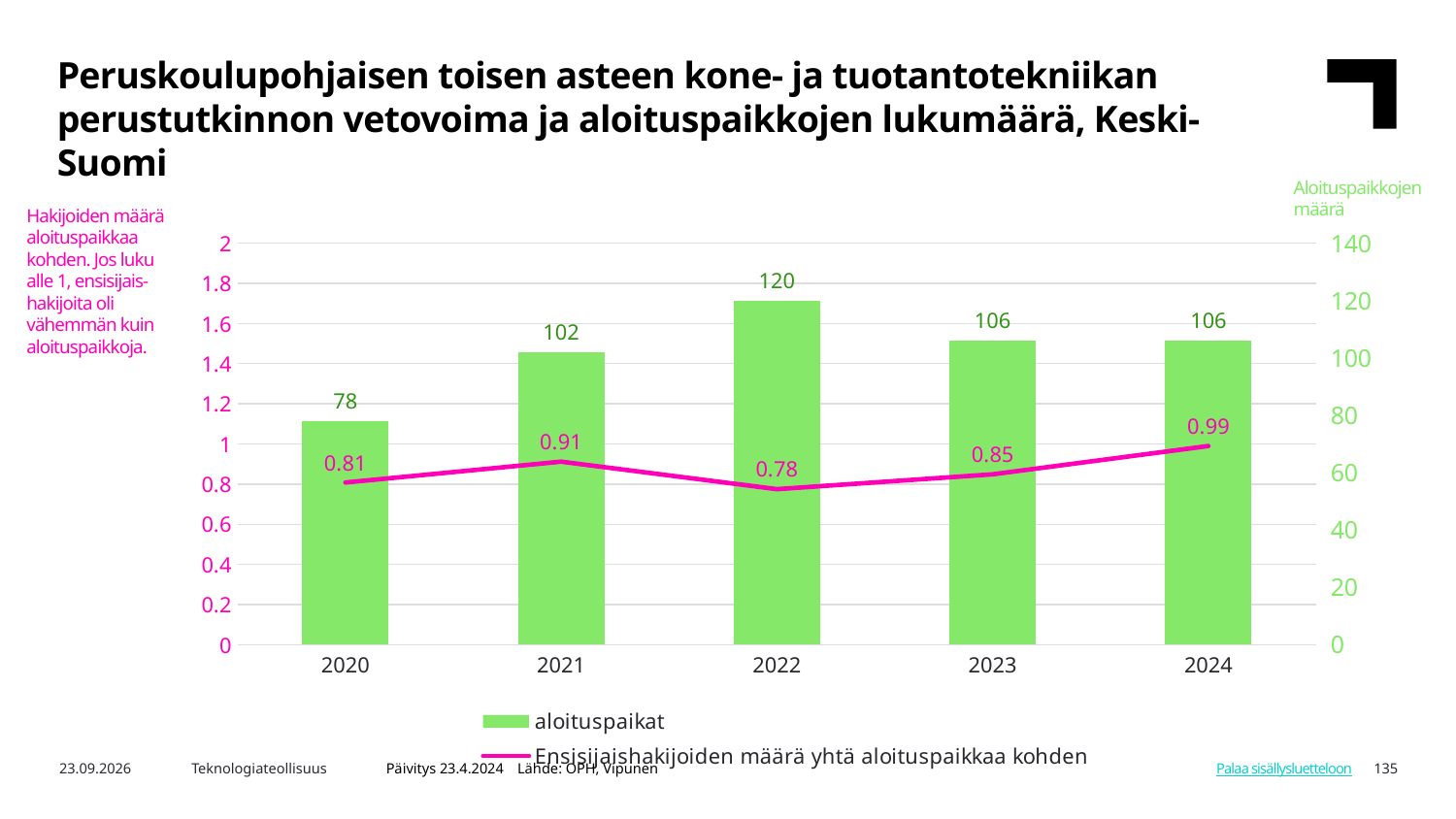
Which year has the lowest value for Ensisijaishakijoiden määrä yhtä aloituspaikkaa kohden? 2022 Which year has the larger value for Ensisijaishakijoiden määrä yhtä aloituspaikkaa kohden, 2021 or 2023? 2021 What is the value of aloituspaikat for 2020? 78 What is the value of aloituspaikat for 2022? 120 What colour are the aloituspaikat bars? Green What is the difference in aloituspaikat between 2022 and 2021? 18 What is the value of Ensisijaishakijoiden määrä yhtä aloituspaikkaa kohden for 2024? 0.99 Which year has the highest value for aloituspaikat? 2022 How many years are shown on the x axis? 5 Does the value of Ensisijaishakijoiden määrä yhtä aloituspaikkaa kohden rise or fall from 2022 to 2024? rise What kind of chart is shown on the slide? Combined bar and line chart How many series does the legend list? 2